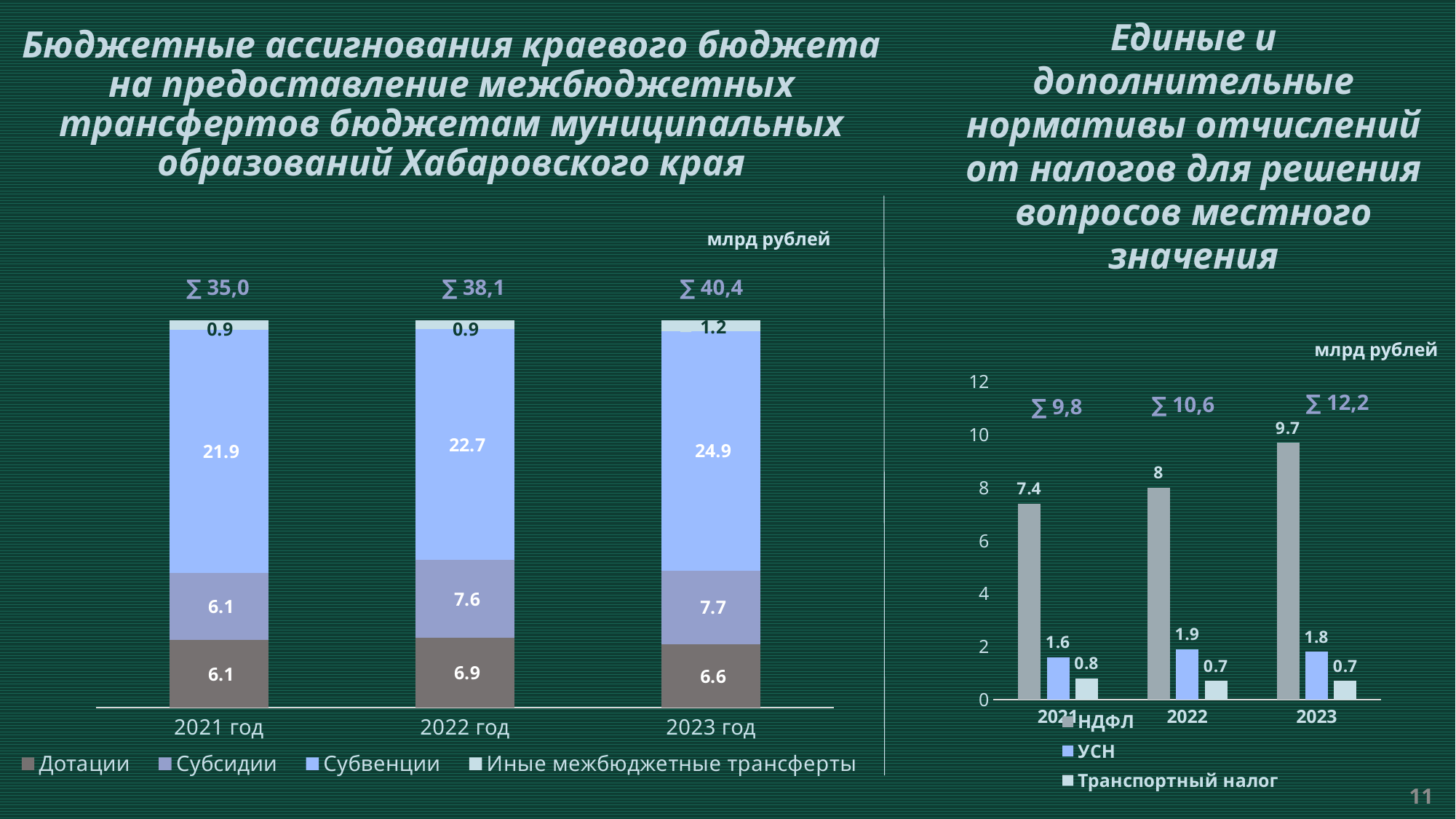
On the left chart, what is the value of Субвенции for 2023 год? 24.9 On the left chart, how many series does the legend list? 4 On the right chart, what is the difference between НДФЛ in 2023 and НДФЛ in 2021? 2.3 On the right chart, what is the total shown for 2023? 12,2 On the right chart, is the value of НДФЛ for 2022 greater or less than УСН for 2022? greater On the left chart, what is the difference between Субсидии in 2023 год and Субсидии in 2021 год? 1.6 On the left chart, does the value of Субвенции rise or fall from 2021 год to 2023 год? rise On the right chart, what is the value of НДФЛ for 2023? 9.7 On the right chart, which year has the highest value for УСН? 2022 On the left chart, what is the total shown above the 2021 год bar? 35,0 On the left chart, what is the value of Дотации for 2022 год? 6.9 What kind of chart is the right chart? bar chart